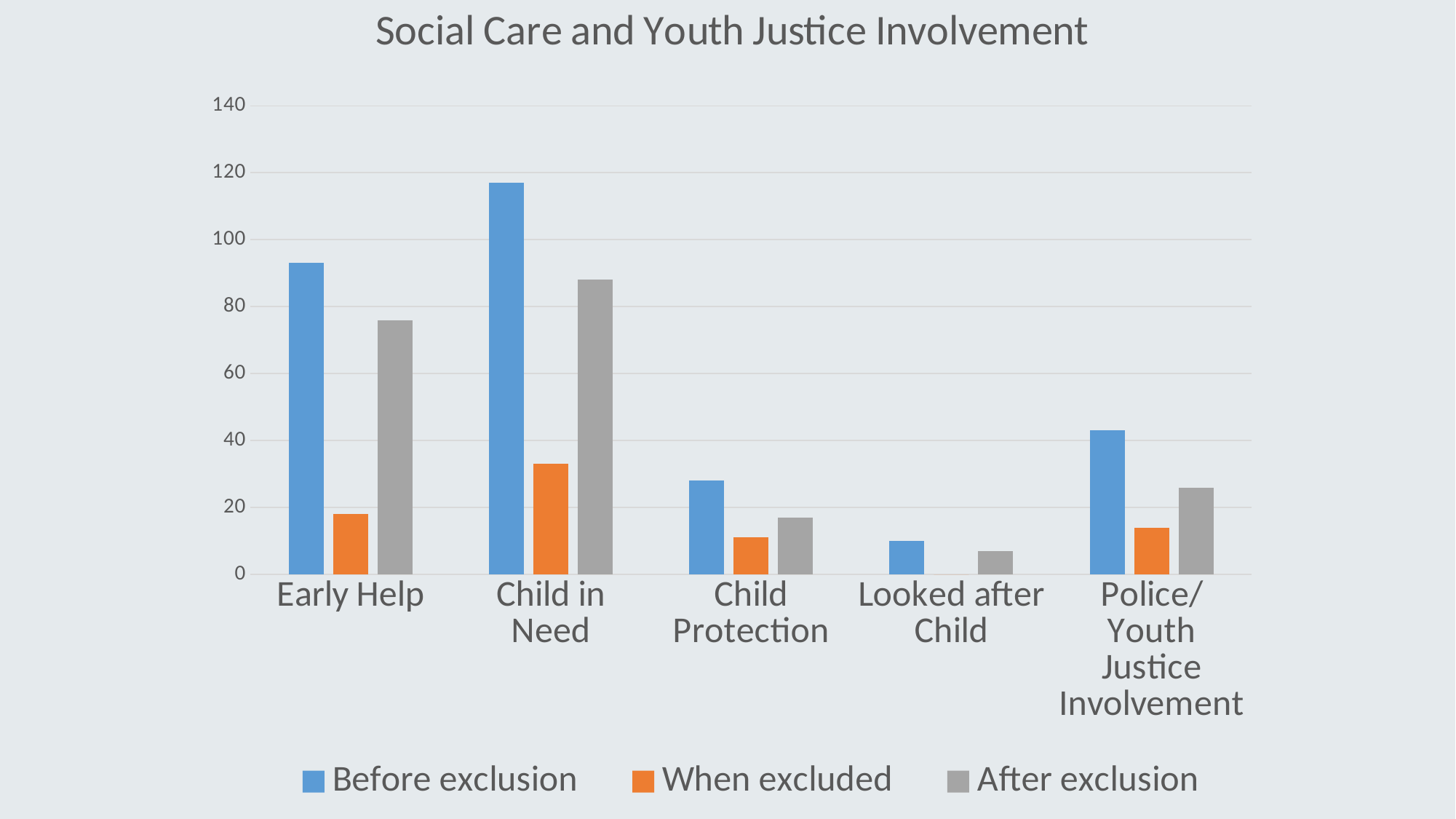
How many series does the legend list? 3 Which category has the lowest value for Before exclusion? Looked after Child For Police/ Youth Justice Involvement, which is larger: Before exclusion or After exclusion? Before exclusion Is the Before exclusion value for Child in Need greater or less than 100? greater Which category has the highest value for After exclusion? Child in Need Which category has the highest value for Before exclusion? Child in Need What kind of chart is shown on the slide? bar chart Is the After exclusion value for Early Help greater or less than 80? less How many categories are shown on the x axis? 5 Is the When excluded value for Child in Need greater or less than 40? less Which series is shown in orange in the legend? When excluded What is the title of the chart? Social Care and Youth Justice Involvement